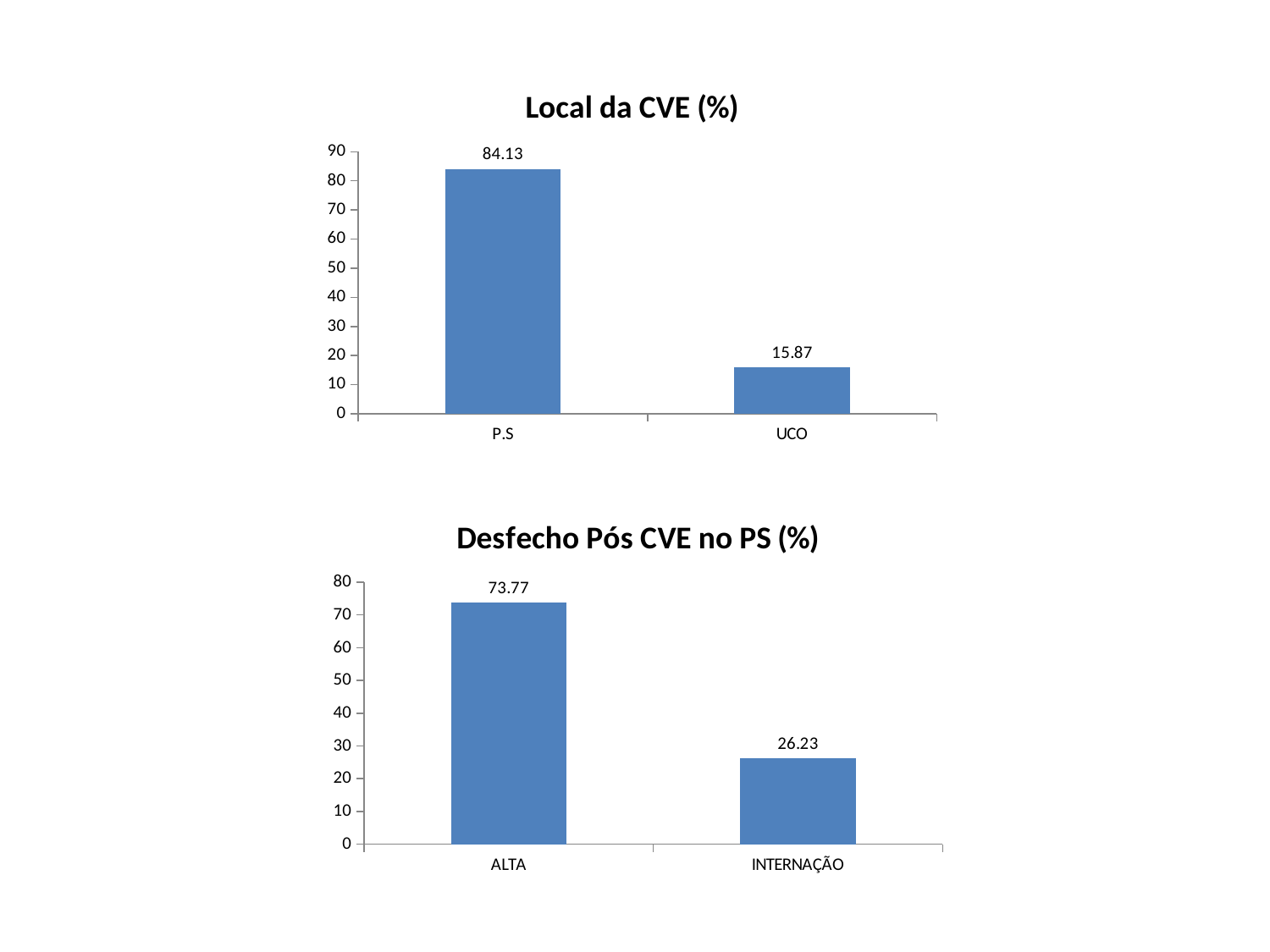
In the 'Desfecho Pós CVE no PS (%)' chart, which category has the lowest value? INTERNAÇÃO In the 'Local da CVE (%)' chart, what is the value for UCO? 15.87 What kind of chart is the 'Local da CVE (%)' chart? Bar chart In the 'Local da CVE (%)' chart, how many categories are shown? 2 What is the title of the bottom chart on the slide? Desfecho Pós CVE no PS (%) In the 'Desfecho Pós CVE no PS (%)' chart, what is the value for ALTA? 73.77 In the 'Local da CVE (%)' chart, what is the value for P.S? 84.13 In the 'Local da CVE (%)' chart, what is the difference between the values for P.S and UCO? 68.26 In the 'Desfecho Pós CVE no PS (%)' chart, what is the difference between the values for ALTA and INTERNAÇÃO? 47.54 In the 'Desfecho Pós CVE no PS (%)' chart, which is larger, the value for ALTA or the value for INTERNAÇÃO? ALTA In the 'Local da CVE (%)' chart, which category has the highest value? P.S In the 'Desfecho Pós CVE no PS (%)' chart, what is the value for INTERNAÇÃO? 26.23